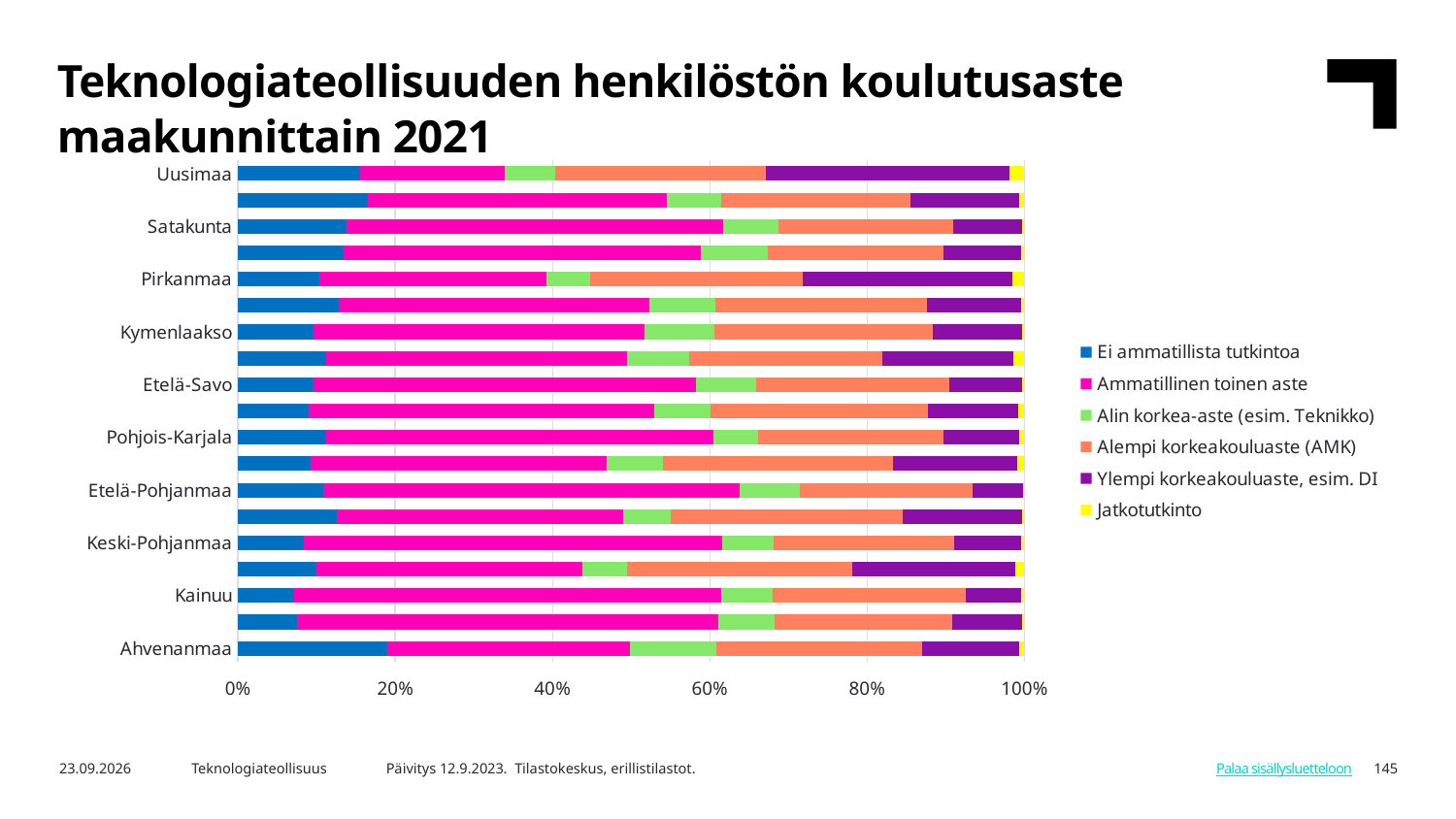
Which has the larger share of Ei ammatillista tutkintoa, Ahvenanmaa or Kainuu? Ahvenanmaa Which region has the largest share of Ei ammatillista tutkintoa? Ahvenanmaa What is the title of the chart? Teknologiateollisuuden henkilöstön koulutusaste maakunnittain 2021 How many series does the legend list? 6 How many bars (regions) are plotted in the chart? 19 Is the value for Ahvenanmaa in the series Ei ammatillista tutkintoa greater or less than 10%? greater Is the value for Pirkanmaa in the series Ylempi korkeakouluaste, esim. DI greater or less than 20%? greater What kind of chart is shown on the slide? Stacked bar chart Which legend entry is shown in yellow? Jatkotutkinto Is the value for Uusimaa in the series Ylempi korkeakouluaste, esim. DI greater or less than 20%? greater